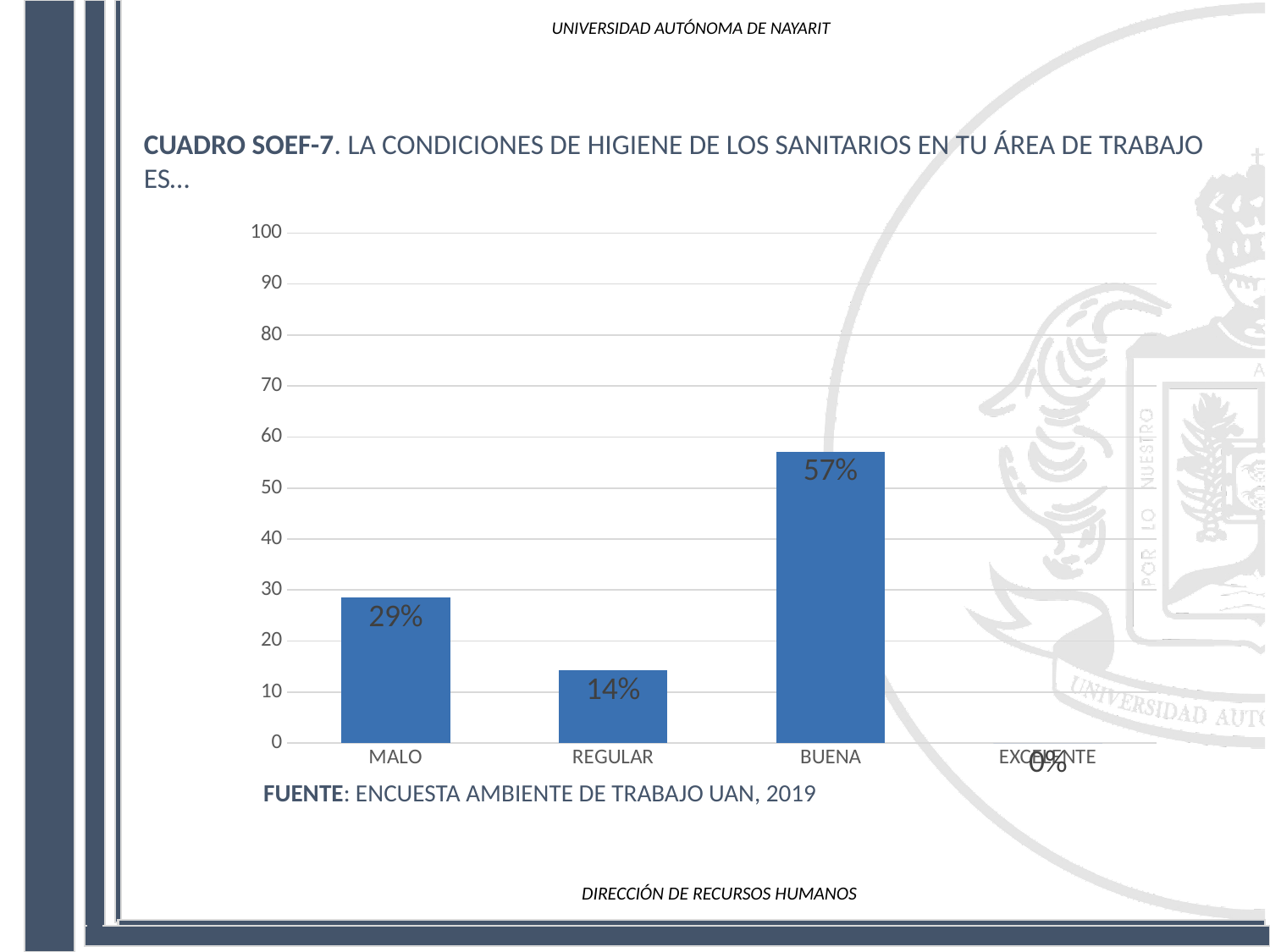
Which category has the lowest value? EXCELENTE What kind of chart is shown on the slide? bar chart What is the difference between the values for BUENA and MALO? 28% What source is cited below the chart? ENCUESTA AMBIENTE DE TRABAJO UAN, 2019 Which is larger, the value for MALO or the value for REGULAR? MALO What is the value for MALO? 29% What is the value for REGULAR? 14% What is the value for BUENA? 57% Is the value for BUENA greater or less than 50? greater How many categories are shown on the x axis? 4 What is the value for EXCELENTE? 0% Which category has the highest value? BUENA